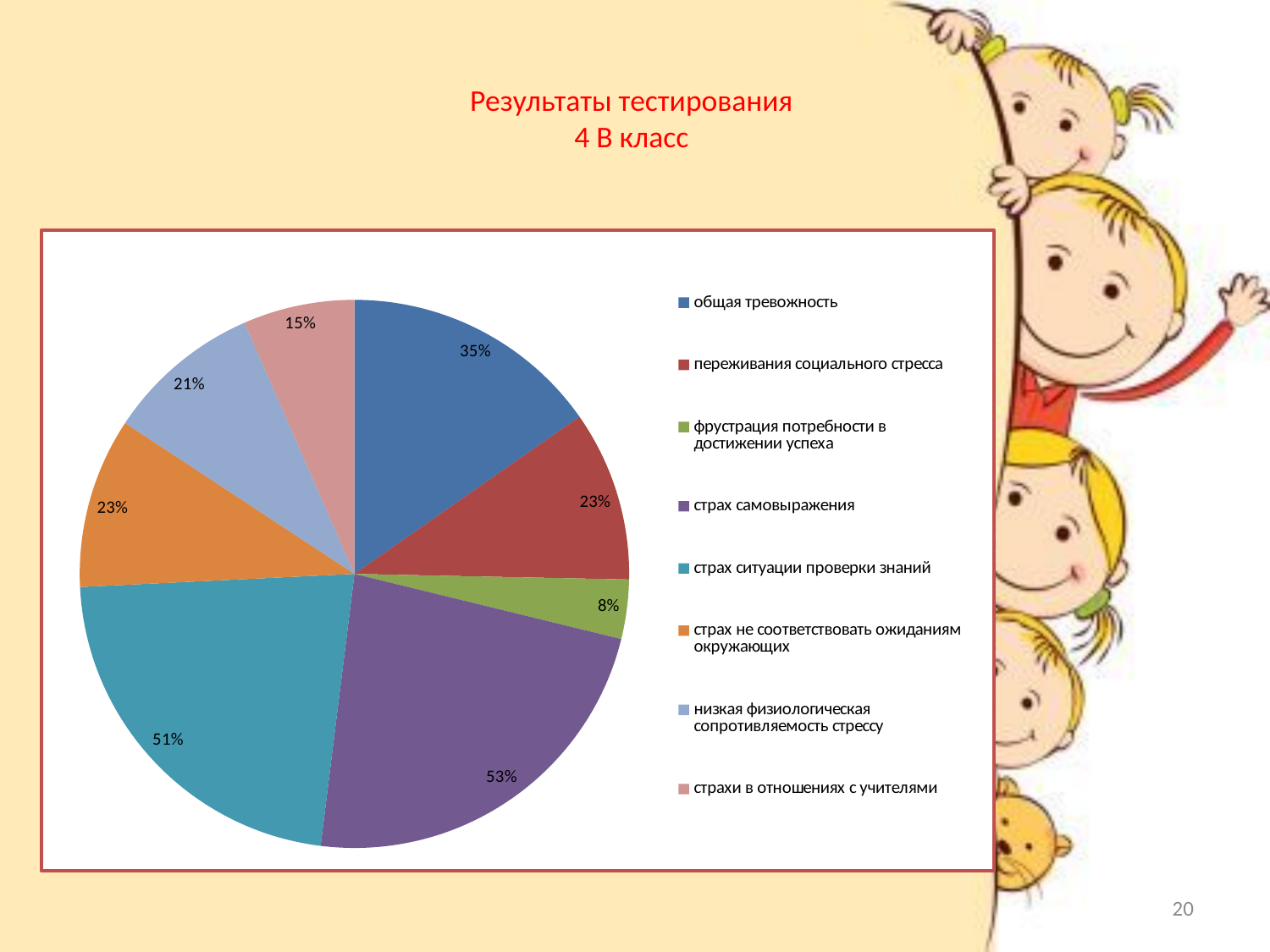
What is the difference between the percentages for страх самовыражения and страх ситуации проверки знаний? 2% What is the title of the slide? Результаты тестирования 4 В класс Which is larger: the value for общая тревожность or the value for низкая физиологическая сопротивляемость стрессу? общая тревожность Which category has the largest slice of the pie? страх самовыражения How many categories does the pie chart show? 8 What percentage is shown for страхи в отношениях с учителями? 15% What percentage is shown for страх самовыражения? 53% What percentage is shown for фрустрация потребности в достижении успеха? 8% Which category has the smallest slice of the pie? фрустрация потребности в достижении успеха Which legend entry is shown in orange? страх не соответствовать ожиданиям окружающих What type of chart is shown on the slide? pie chart What percentage is shown for общая тревожность? 35%